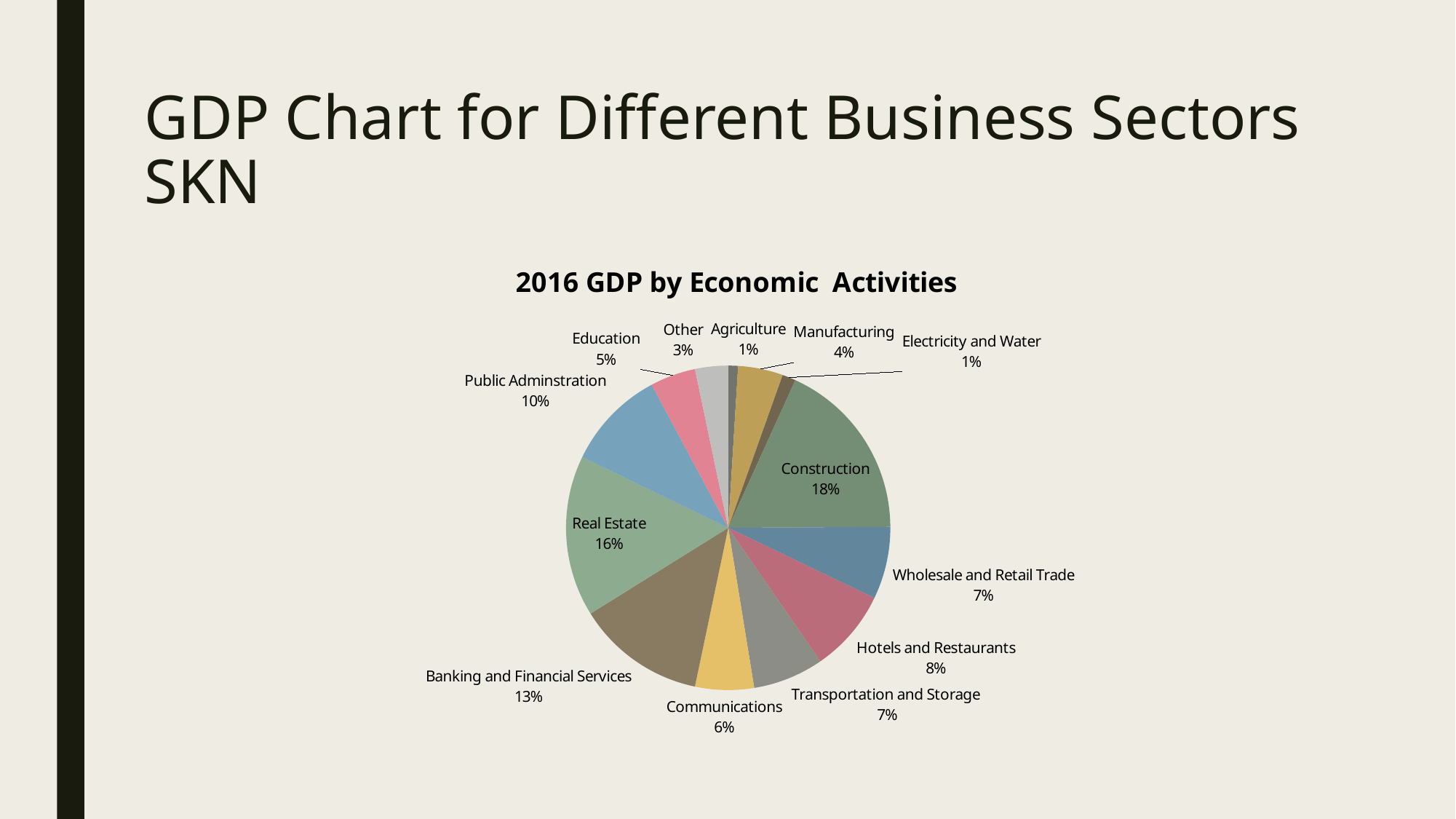
Which has a larger share, Manufacturing or Other? Manufacturing How many slices does the pie chart have? 13 What is the title of the chart? 2016 GDP by Economic Activities What is the difference between the shares of Banking and Financial Services and Communications? 7% Which economic activity has the largest share of the pie? Construction Which has a larger share, Public Adminstration or Education? Public Adminstration What percentage is shown for Real Estate? 16% What kind of chart is shown on the slide? Pie chart What is the difference between the shares of Construction and Real Estate? 2% What percentage is shown for Hotels and Restaurants? 8% What is the value for Banking and Financial Services? 13% What share of GDP does Construction account for? 18%